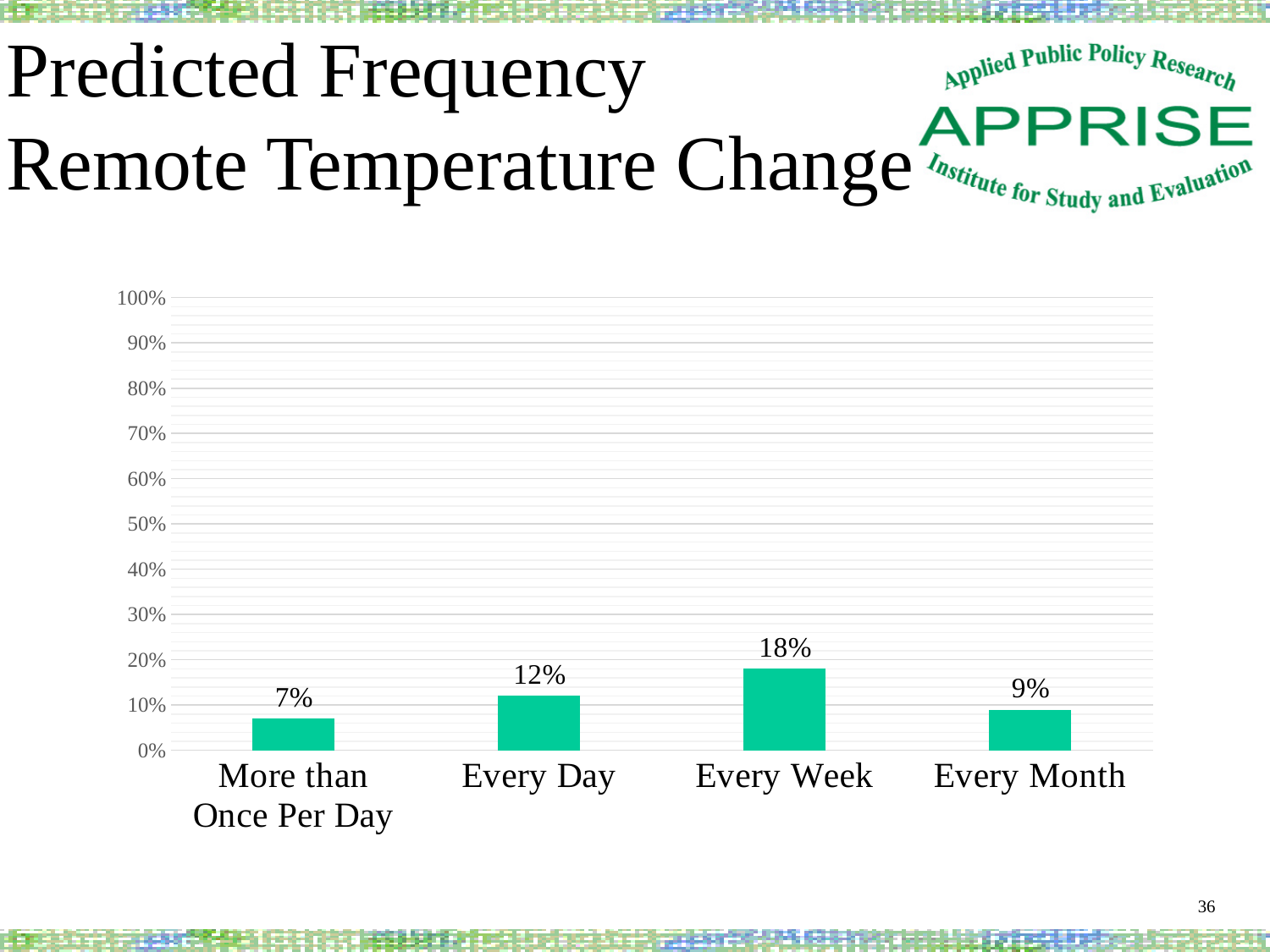
Which category has the highest value? Every Week How many categories are shown on the x axis? 4 What is the value for Every Day? 12% What is the value for Every Month? 9% What is the difference between the values for Every Week and Every Day? 6% What is the highest value shown on the y axis? 100% Is the value for Every Week greater or less than 20%? less What is the value for Every Week? 18% Which is larger, the value for Every Day or the value for Every Month? Every Day What kind of chart is shown on the slide? bar chart Which category has the lowest value? More than Once Per Day What is the value for More than Once Per Day? 7%